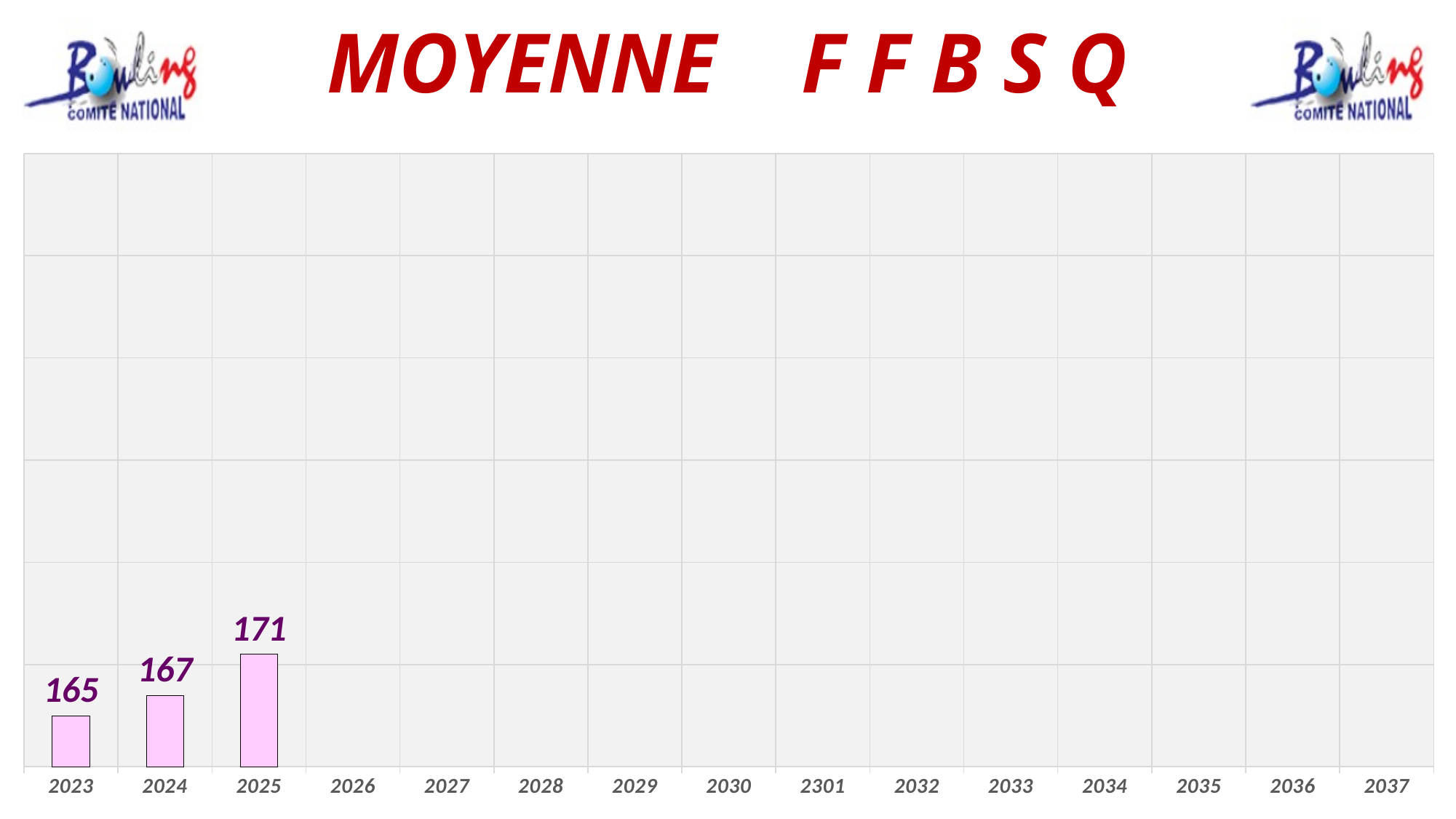
What is the difference between the values for 2025 and 2023? 6 Which is larger, the value for 2024 or the value for 2025? 2025 What is the value for 2025? 171 What kind of chart is shown on the slide? bar chart How many year labels are shown on the x axis? 15 Which year has the lowest plotted value? 2023 What is the difference between the values for 2024 and 2023? 2 What is the value for 2024? 167 What is the value for 2023? 165 How many bars have values plotted on the chart? 3 Which year has the highest plotted value? 2025 Do the plotted values rise or fall from 2023 to 2025? rise